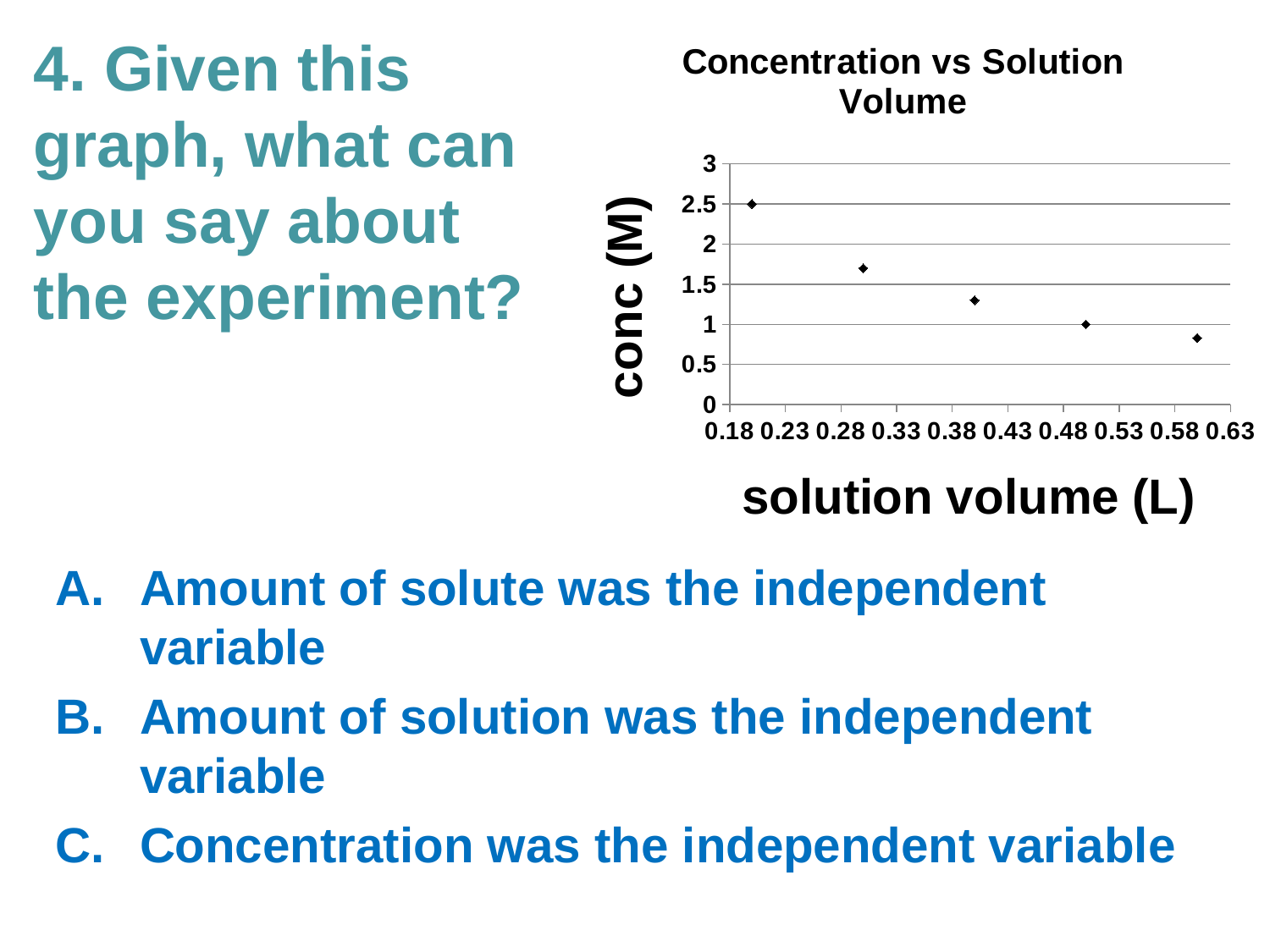
Is the concentration of the point with the smallest solution volume greater or less than 2? greater What kind of chart is shown on the slide? scatter plot Is the concentration of the second point from the left greater or less than 1.5? greater Is the concentration of the third point from the left greater or less than 1.5? less What is the highest value shown on the y axis? 3 Which has the higher concentration: the point with the smallest solution volume or the point with the largest solution volume? the point with the smallest solution volume How many data points are plotted on the chart? 5 What is the concentration of the highest plotted point? 2.5 Does concentration rise or fall as solution volume increases along the x axis? fall What is the title of the chart? Concentration vs Solution Volume What is the label of the y axis? conc (M)